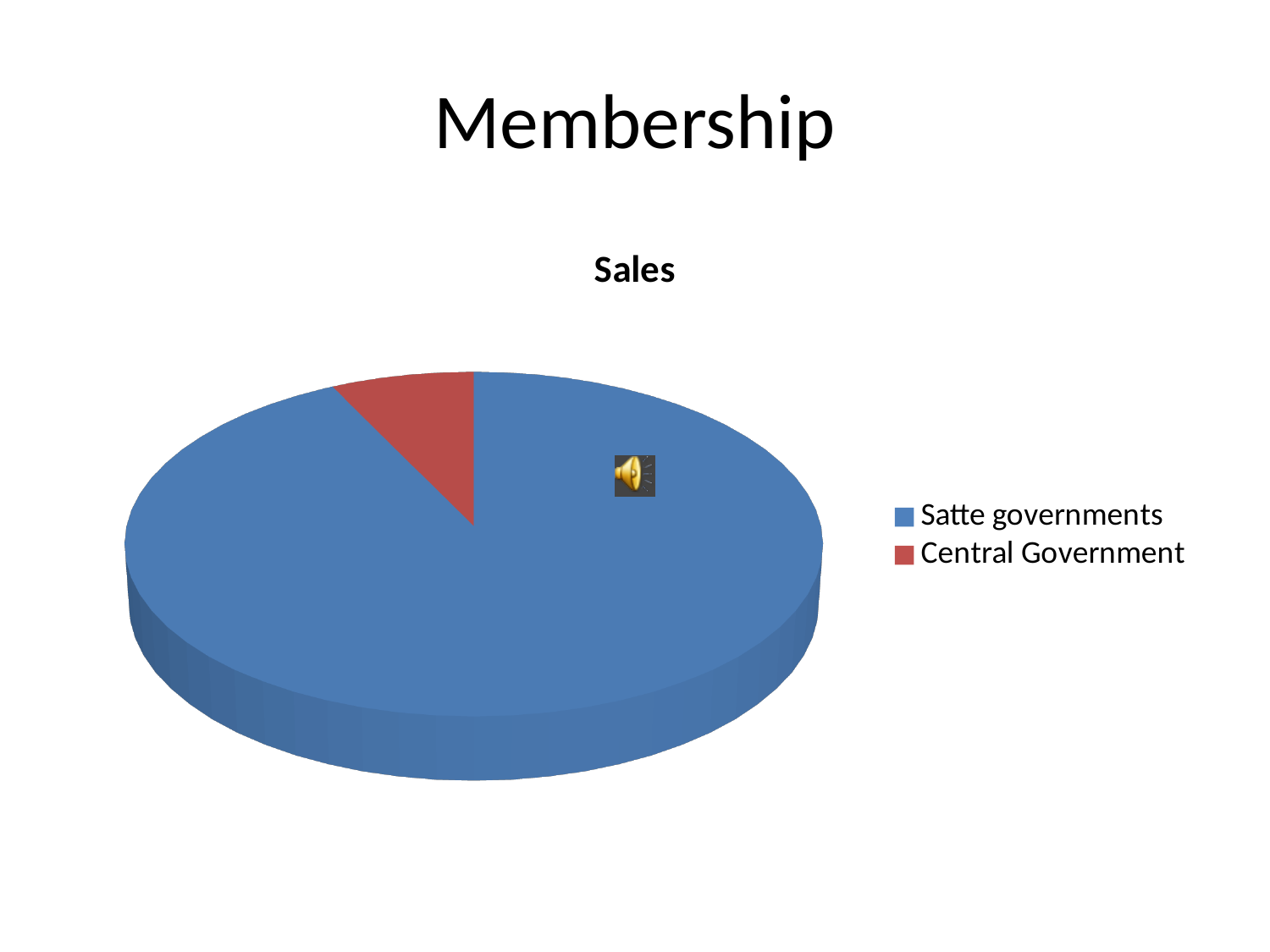
What kind of chart is shown on the slide? pie chart What colour is the slice for Central Government? red Which category has the smallest slice of the pie? Central Government How many slices does the pie chart have? 2 Which slice is larger, Satte governments or Central Government? Satte governments How many entries does the legend list? 2 Which category has the largest slice of the pie? Satte governments What is the title of the chart? Sales